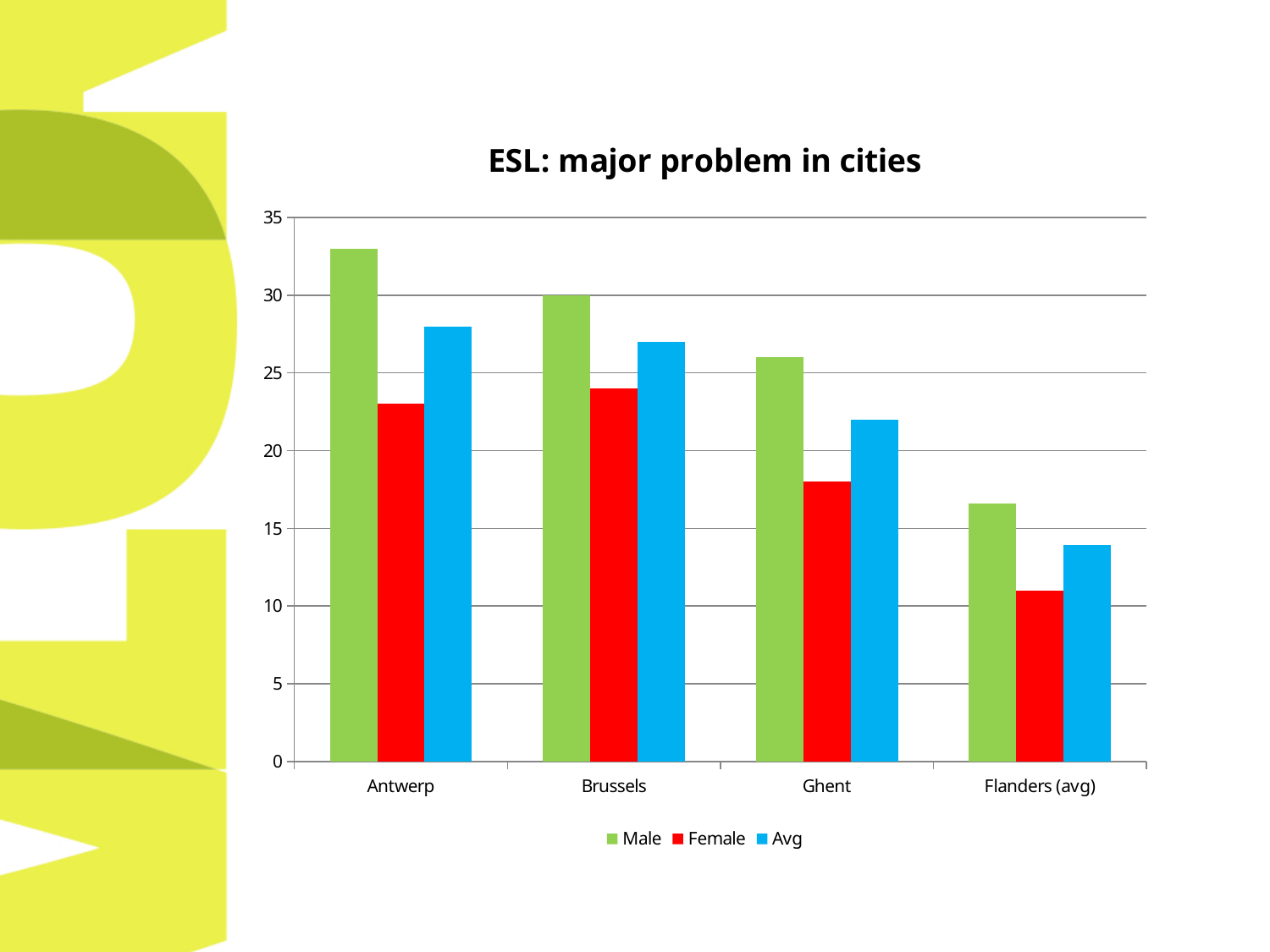
Do the Avg values rise or fall from Antwerp to Flanders (avg) along the x axis? fall What is the title of the chart? ESL: major problem in cities Is the Male value for Antwerp greater or less than 30? greater Is the Female value for Ghent greater or less than 20? less Which category has the highest Male value? Antwerp How many series does the legend list? 3 What kind of chart is shown on the slide? bar chart Is the Avg value for Flanders (avg) greater or less than 15? less Which category has the lowest Female value? Flanders (avg) What is the Male value for Brussels? 30 How many categories are shown on the x axis? 4 Which is larger, the Male value for Ghent or the Female value for Ghent? Male value for Ghent